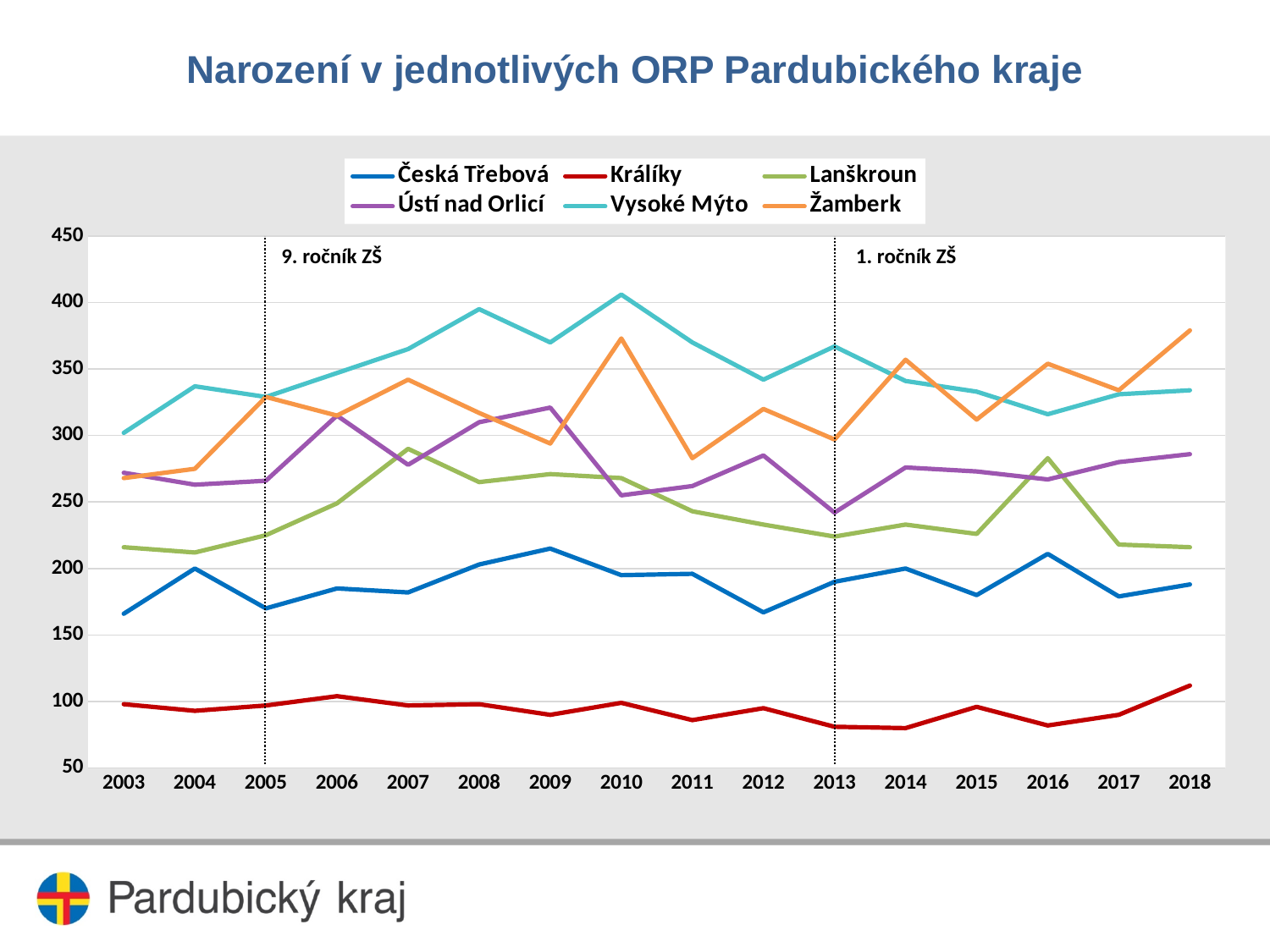
In which year does Vysoké Mýto reach its highest value? 2010 What kind of chart is shown on the slide? line chart Which series has the highest value in 2010? Vysoké Mýto Which series has the lowest values across all years? Králíky What is the title of the chart? Narození v jednotlivých ORP Pardubického kraje Is the value for Lanškroun in 2016 greater or less than 250? greater Does the value for Králíky rise or fall from 2016 to 2018? rise Is the value for Česká Třebová in 2012 greater or less than 200? less Is the value for Králíky in 2014 greater or less than 100? less How many years are shown on the x axis? 16 In 2018, which is larger: the value for Žamberk or the value for Vysoké Mýto? Žamberk How many series does the legend list? 6